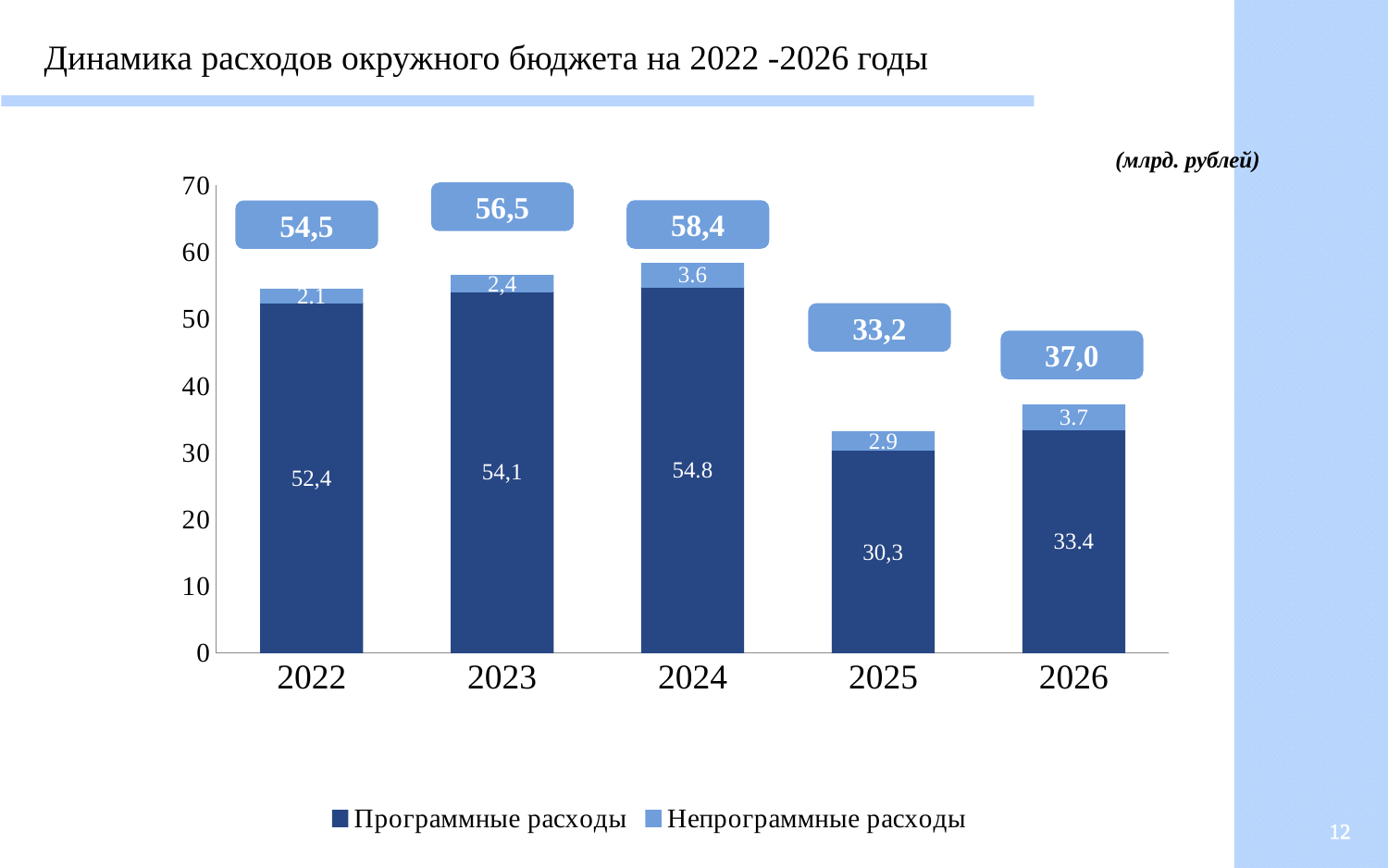
Which year has the highest total expenditure? 2024 Which year has the lowest total expenditure? 2025 How many series does the legend list? 2 What is the value of Непрограммные расходы for 2024? 3.6 What is the value of Программные расходы for 2025? 30,3 What type of chart is shown on the slide? Stacked bar chart What is the total shown above the bar for 2023? 56,5 What is the difference between the total for 2024 and the total for 2025? 25,2 What is the value of Программные расходы for 2022? 52,4 Which is larger: Программные расходы in 2023 or in 2026? 2023 What unit is indicated for the values on the chart? млрд. рублей How many years are shown on the x axis? 5